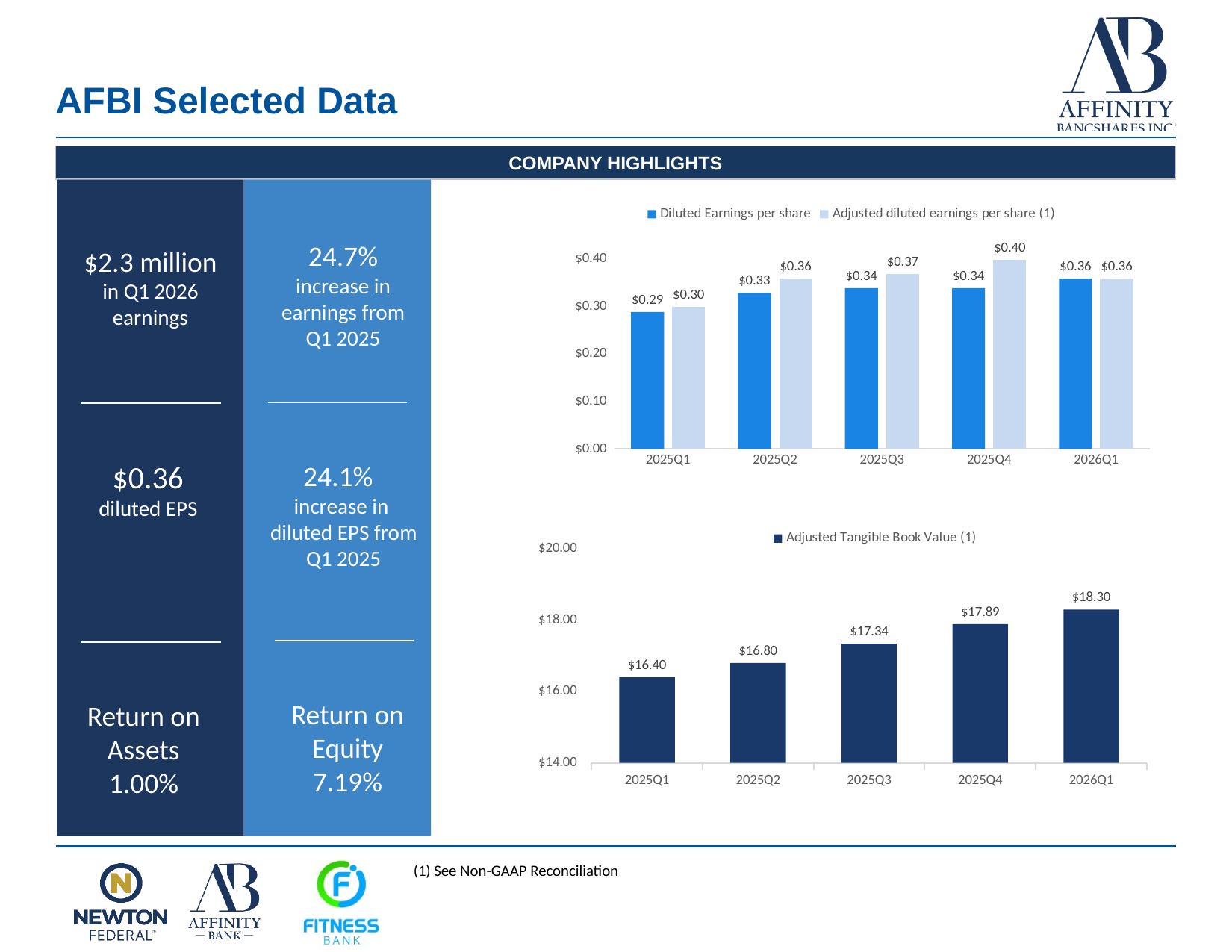
In the bottom chart (Adjusted Tangible Book Value), what is the difference between the 2026Q1 and 2025Q1 values? $1.90 In the top chart (earnings per share), what is the Adjusted diluted earnings per share value for 2025Q4? $0.40 In the top chart (earnings per share), what is the difference between Adjusted diluted earnings per share and Diluted Earnings per share in 2025Q4? $0.06 What kind of chart is the bottom chart (Adjusted Tangible Book Value)? bar chart In the bottom chart (Adjusted Tangible Book Value), how many quarters are plotted? 5 In the top chart (earnings per share), which quarter has the lowest Diluted Earnings per share? 2025Q1 In the top chart (earnings per share), how many series does the legend list? 2 In the top chart (earnings per share), which quarter has the highest Adjusted diluted earnings per share? 2025Q4 In the top chart (earnings per share), does Diluted Earnings per share rise or fall from 2025Q1 to 2026Q1? rise In the bottom chart (Adjusted Tangible Book Value), which quarter has the highest value? 2026Q1 In the bottom chart (Adjusted Tangible Book Value), what is the value for 2025Q3? $17.34 In the top chart (earnings per share), what is the Diluted Earnings per share value for 2025Q1? $0.29